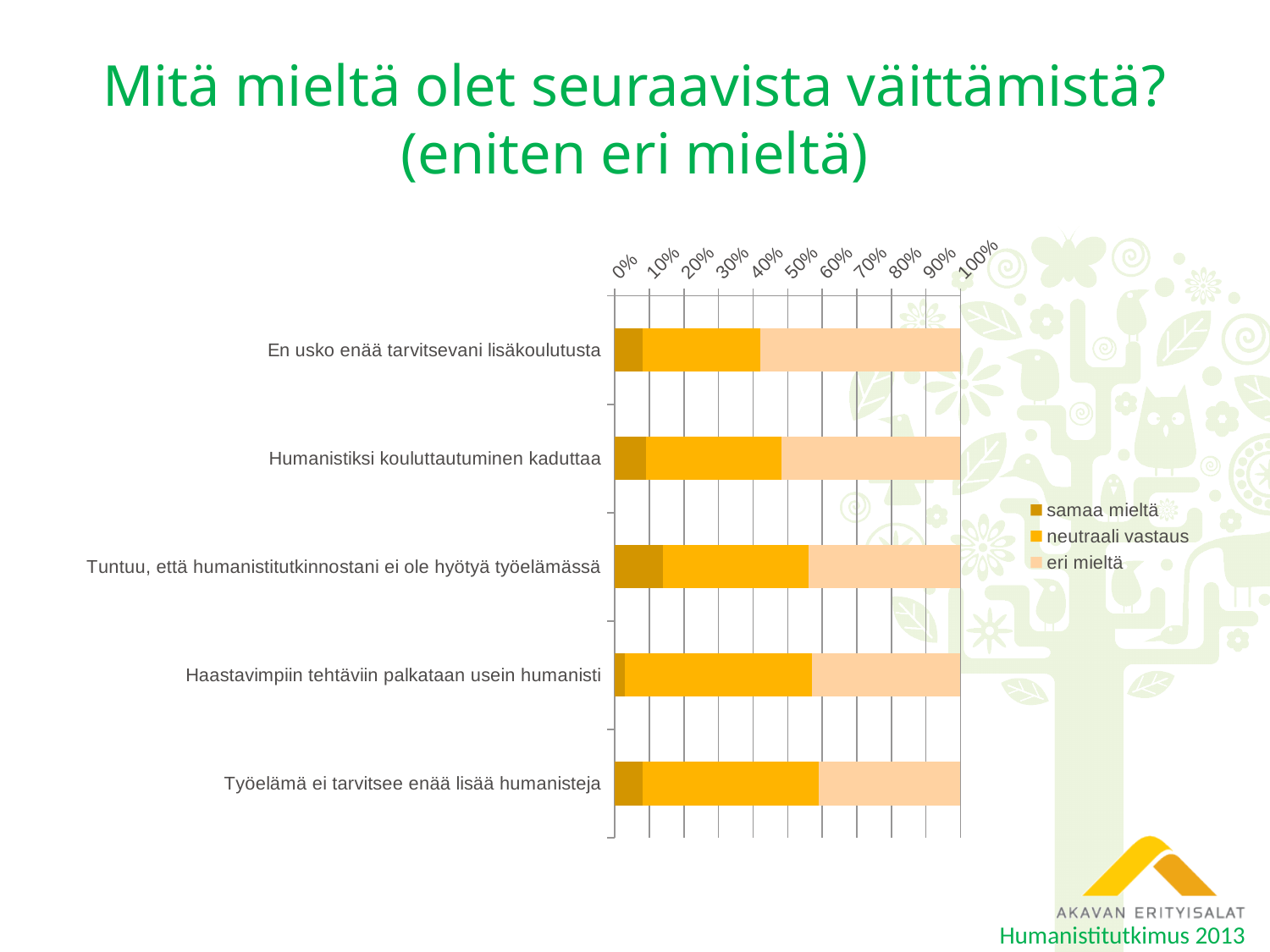
Which statement has the smallest 'samaa mieltä' segment? Haastavimpiin tehtäviin palkataan usein humanisti Which statement has the largest 'samaa mieltä' segment? Tuntuu, että humanistitutkinnostani ei ole hyötyä työelämässä Is the 'neutraali vastaus' share for 'En usko enää tarvitsevani lisäkoulutusta' greater or less than 50%? less Which has the larger 'eri mieltä' share: 'En usko enää tarvitsevani lisäkoulutusta' or 'Työelämä ei tarvitsee enää lisää humanisteja'? En usko enää tarvitsevani lisäkoulutusta How many series does the chart legend list? 3 Is the 'samaa mieltä' share for 'Tuntuu, että humanistitutkinnostani ei ole hyötyä työelämässä' greater or less than 10%? greater Which statement has the largest 'eri mieltä' segment? En usko enää tarvitsevani lisäkoulutusta Is the 'samaa mieltä' share for 'Haastavimpiin tehtäviin palkataan usein humanisti' greater or less than 10%? less What kind of chart is shown on the slide? Stacked bar chart What are the three legend entries of the chart? samaa mieltä, neutraali vastaus, eri mieltä How many statements (categories) are plotted in the chart? 5